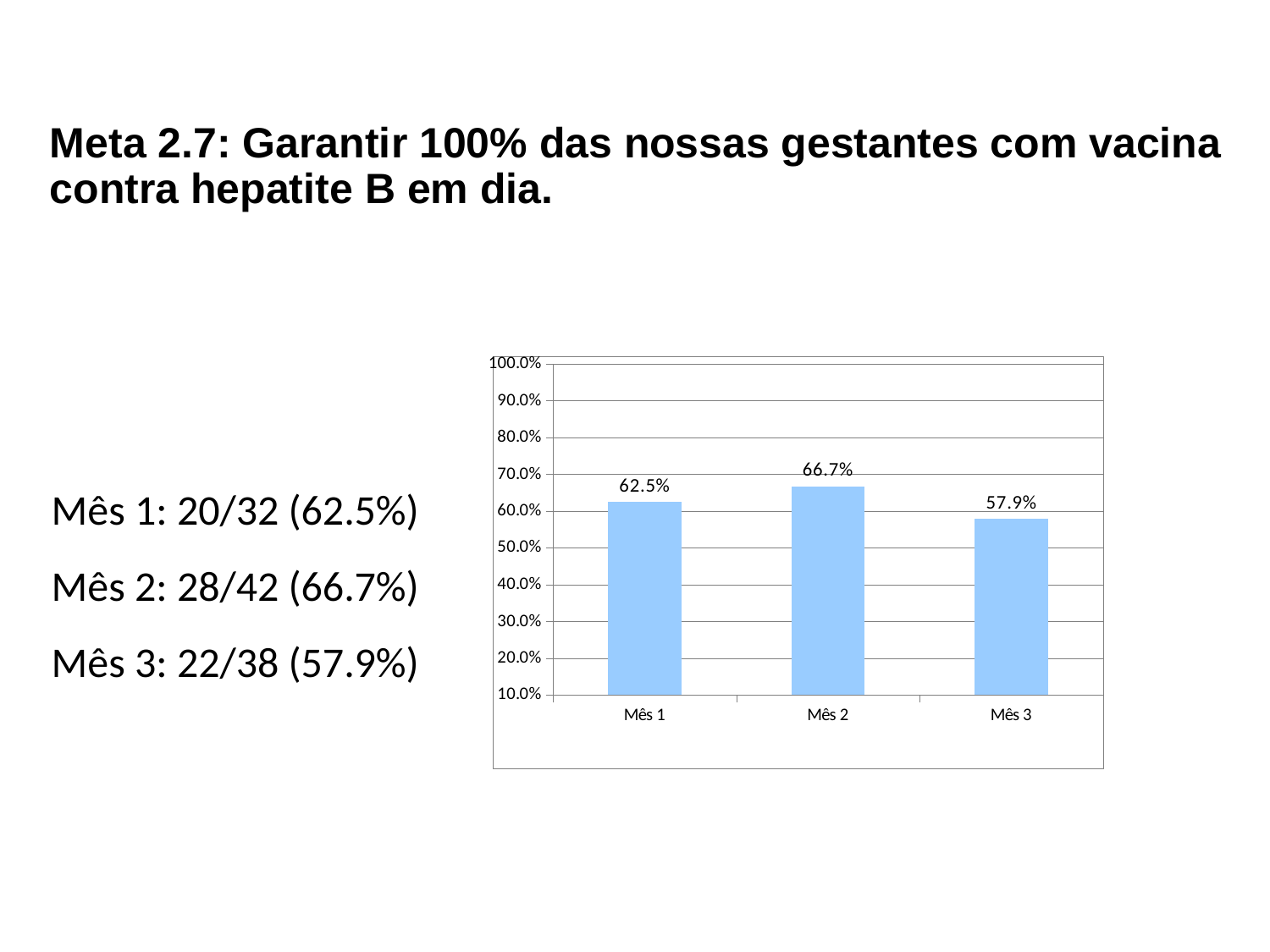
What is the value for Mês 3? 57.9% Which is larger, the value for Mês 1 or the value for Mês 3? Mês 1 How many categories are shown on the x axis? 3 What is the difference between the values for Mês 2 and Mês 3? 8.8% Which month has the highest value? Mês 2 What kind of chart is shown on the slide? bar chart What is the difference between the values for Mês 2 and Mês 1? 4.2% Is the value for Mês 3 greater or less than 60.0%? less What is the highest value shown on the y axis? 100.0% Which month has the lowest value? Mês 3 What is the value for Mês 2? 66.7% What is the value for Mês 1? 62.5%